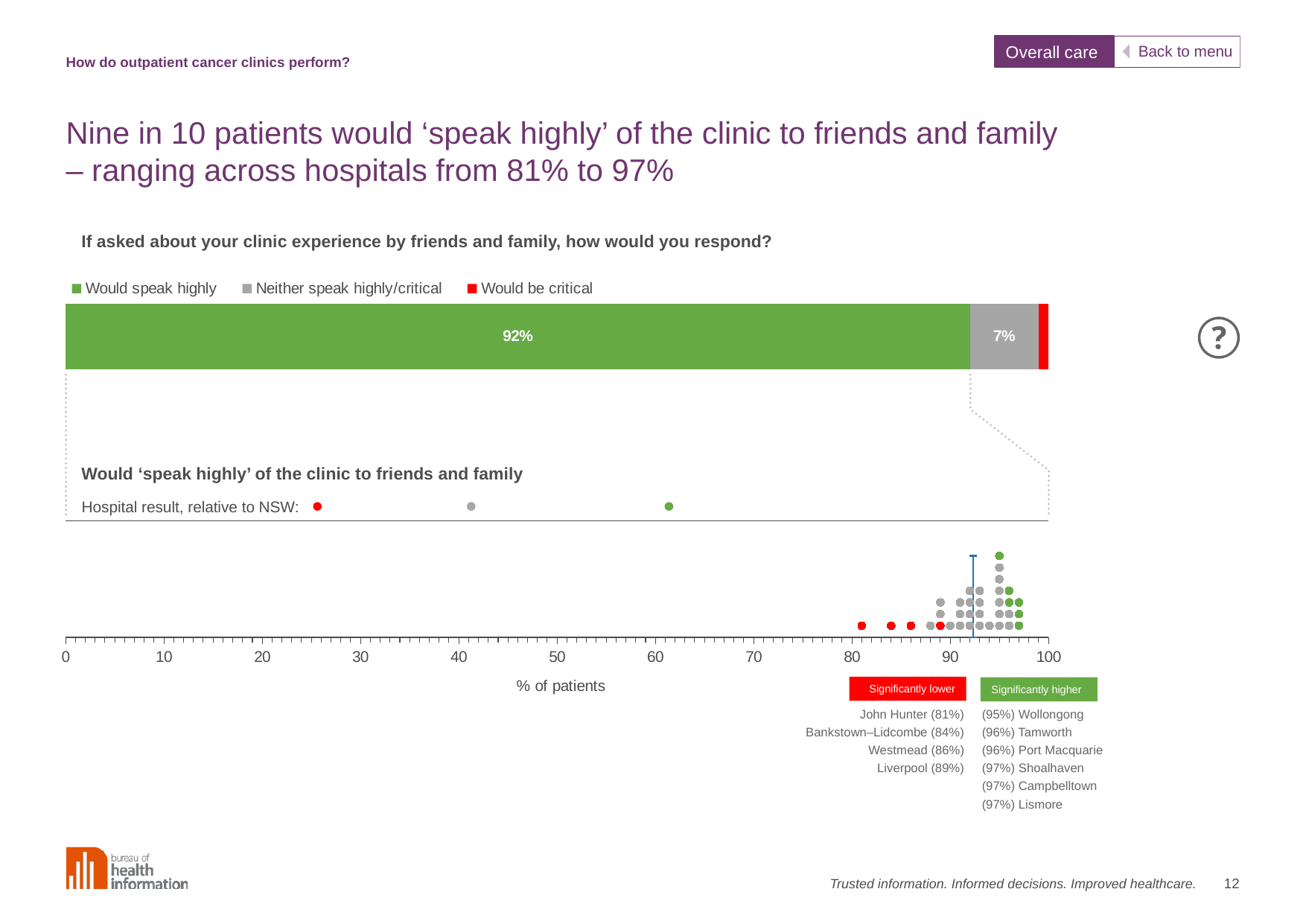
In the stacked bar chart, which is larger: 'Would speak highly' or 'Neither speak highly/critical'? Would speak highly In the stacked bar chart, what percentage of patients would 'Neither speak highly/critical'? 7% In the 'Would speak highly' hospital dot plot, what is the result for Lismore? 97% In the 'Would speak highly' hospital dot plot, which hospital has the lowest result? John Hunter How many series does the legend of the stacked bar chart list? 3 In the 'Would speak highly' hospital dot plot, how many hospitals are listed as 'Significantly lower'? 4 In the stacked bar chart, what percentage of patients 'Would speak highly' of the clinic? 92% In the 'Would speak highly' hospital dot plot, how many hospitals are listed as 'Significantly higher'? 6 What kind of chart shows the 92% and 7% values? Bar chart In the 'Would speak highly' hospital dot plot, what is the difference in percentage points between Liverpool and John Hunter? 8 percentage points In the stacked bar chart, what is the difference in percentage points between 'Would speak highly' and 'Neither speak highly/critical'? 85 percentage points In the 'Would speak highly' hospital dot plot, what is the result for John Hunter? 81%